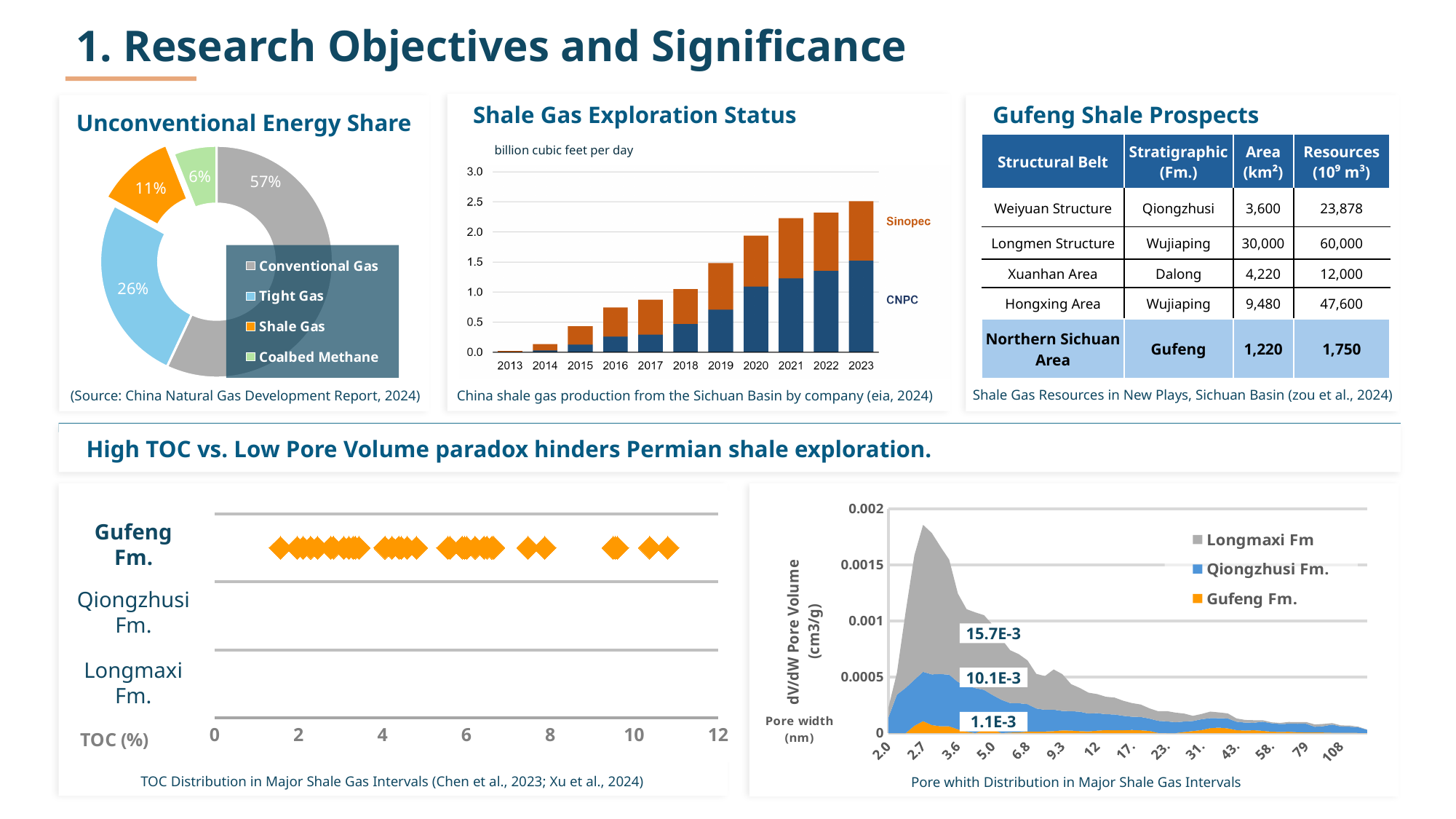
In the Shale Gas Exploration Status chart, which company has the larger value in 2023, CNPC or Sinopec? CNPC In the Unconventional Energy Share chart, which category has the smallest share? Coalbed Methane In the Unconventional Energy Share chart, what is the value for Shale Gas? 11% How many series does the legend of the Shale Gas Exploration Status chart list? 2 How many categories does the Unconventional Energy Share chart show? 4 In the Unconventional Energy Share chart, which category has the largest share? Conventional Gas How many series does the legend of the Pore width Distribution chart (bottom right) list? 3 In the Shale Gas Exploration Status chart, is the total value for 2023 greater or less than 2.0? greater In the Shale Gas Exploration Status chart, do the total values rise or fall from 2013 to 2023? Rise In the Unconventional Energy Share chart, how many percentage points larger is Tight Gas than Shale Gas? 15% What kind of chart is the Shale Gas Exploration Status chart? Stacked bar chart In the Unconventional Energy Share chart, what share does Conventional Gas have? 57%